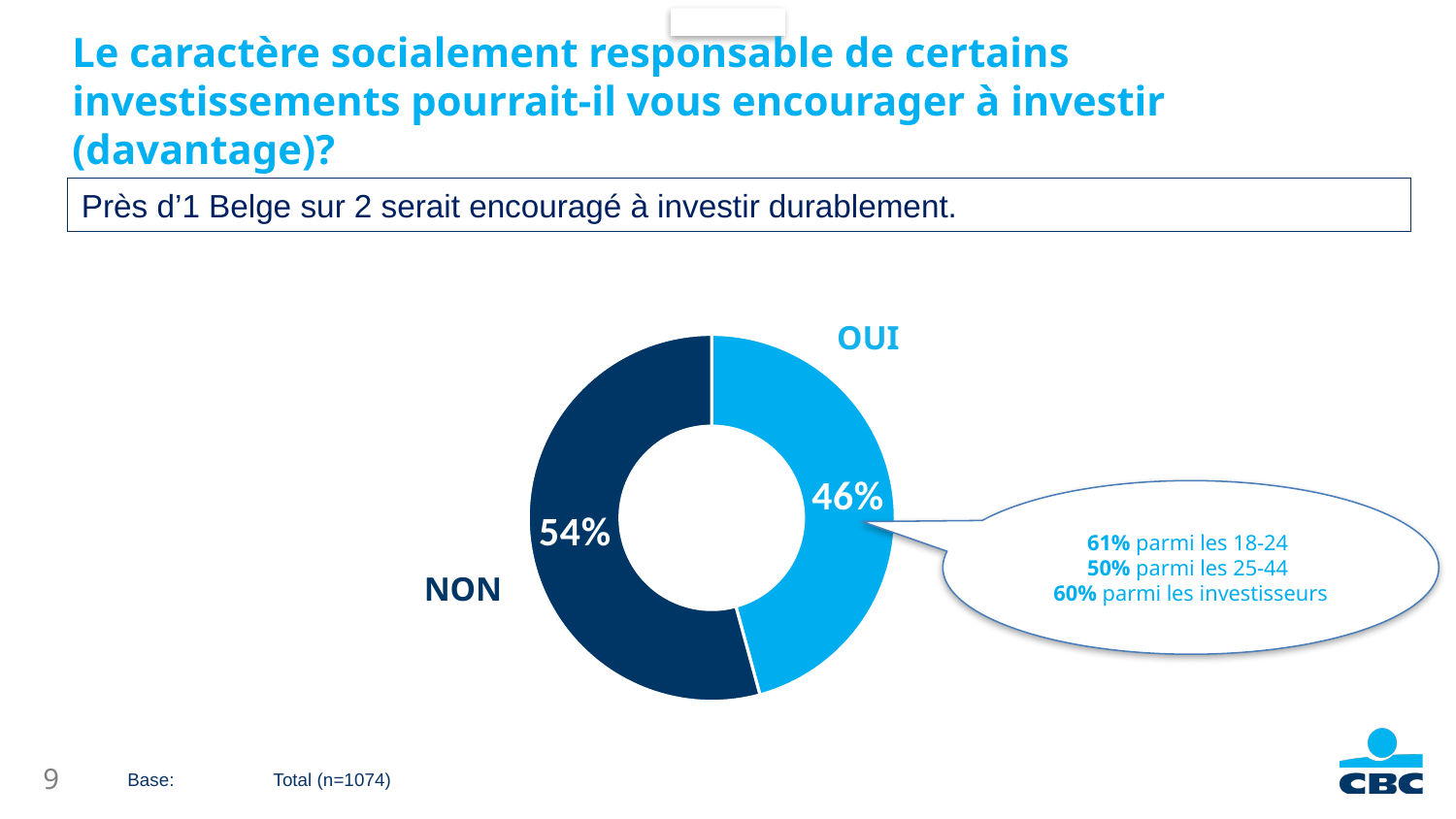
What percentage of respondents answered OUI? 46% How many categories are shown in the chart? 2 Which category has the larger share, OUI or NON? NON What percentage of respondents answered NON? 54% Which category has the smallest share in the chart? OUI According to the callout, what percentage of investors (investisseurs) answered OUI? 60% According to the callout, what percentage of 18-24 year olds answered OUI? 61% What is the difference in percentage points between NON and OUI? 8 Is the share for OUI greater or less than 50%? less What kind of chart is shown on the slide? Doughnut (pie) chart Which colour represents the NON category in the chart? Dark blue What is the sample size (n) given in the base note? 1074